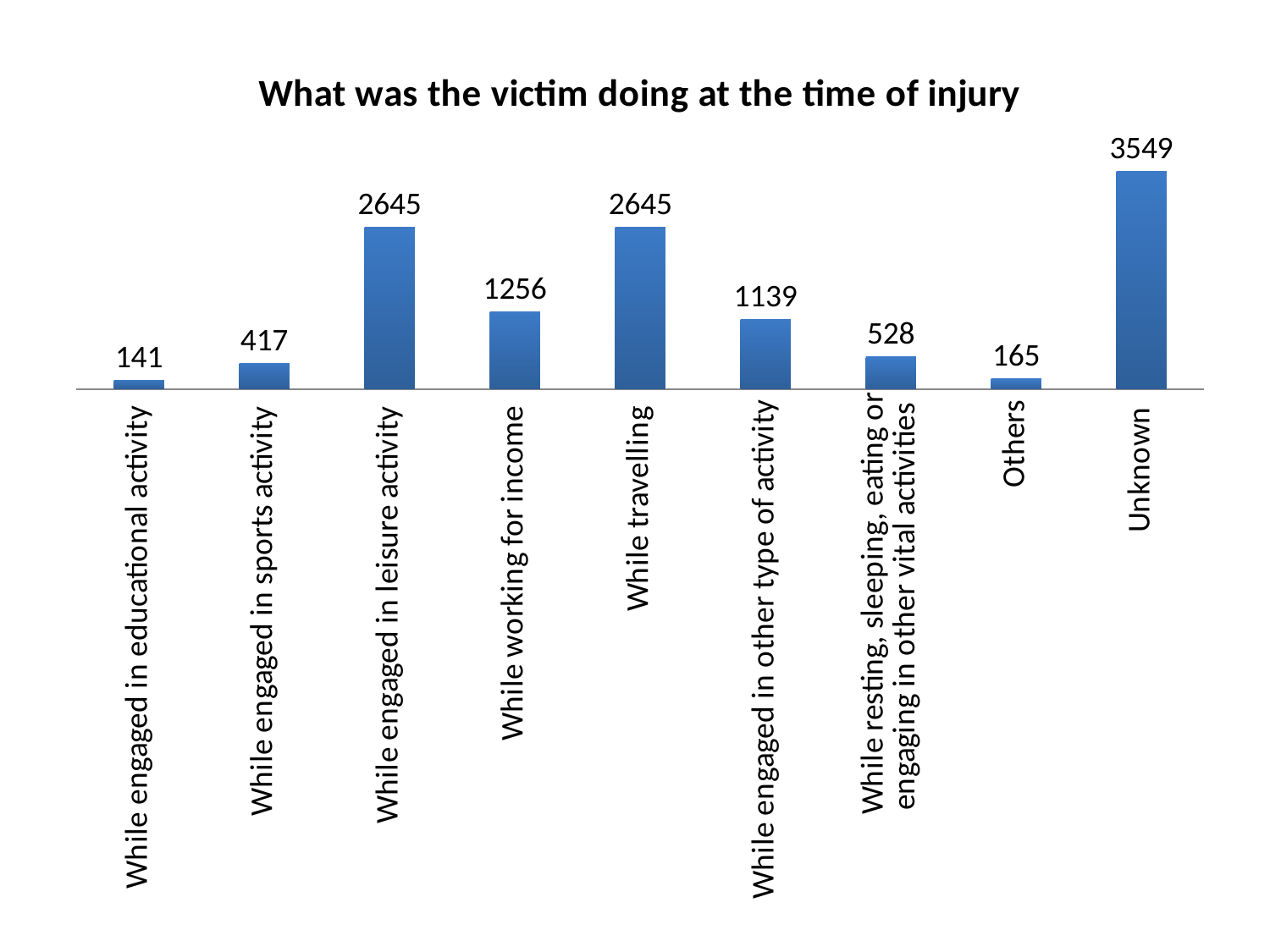
Which category has the highest value? Unknown How many categories are shown on the chart? 9 What is the difference between the values for 'While working for income' and 'While engaged in other type of activity'? 117 What is the value for 'While engaged in sports activity'? 417 Which is larger, the value for 'Others' or the value for 'While engaged in sports activity'? While engaged in sports activity Which category has the lowest value? While engaged in educational activity What is the value for 'While resting, sleeping, eating or engaging in other vital activities'? 528 What is the difference between the values for 'Unknown' and 'While travelling'? 904 What kind of chart is this? Bar chart What is the value for 'While working for income'? 1256 What is the value for 'Unknown'? 3549 What is the title of the chart? What was the victim doing at the time of injury